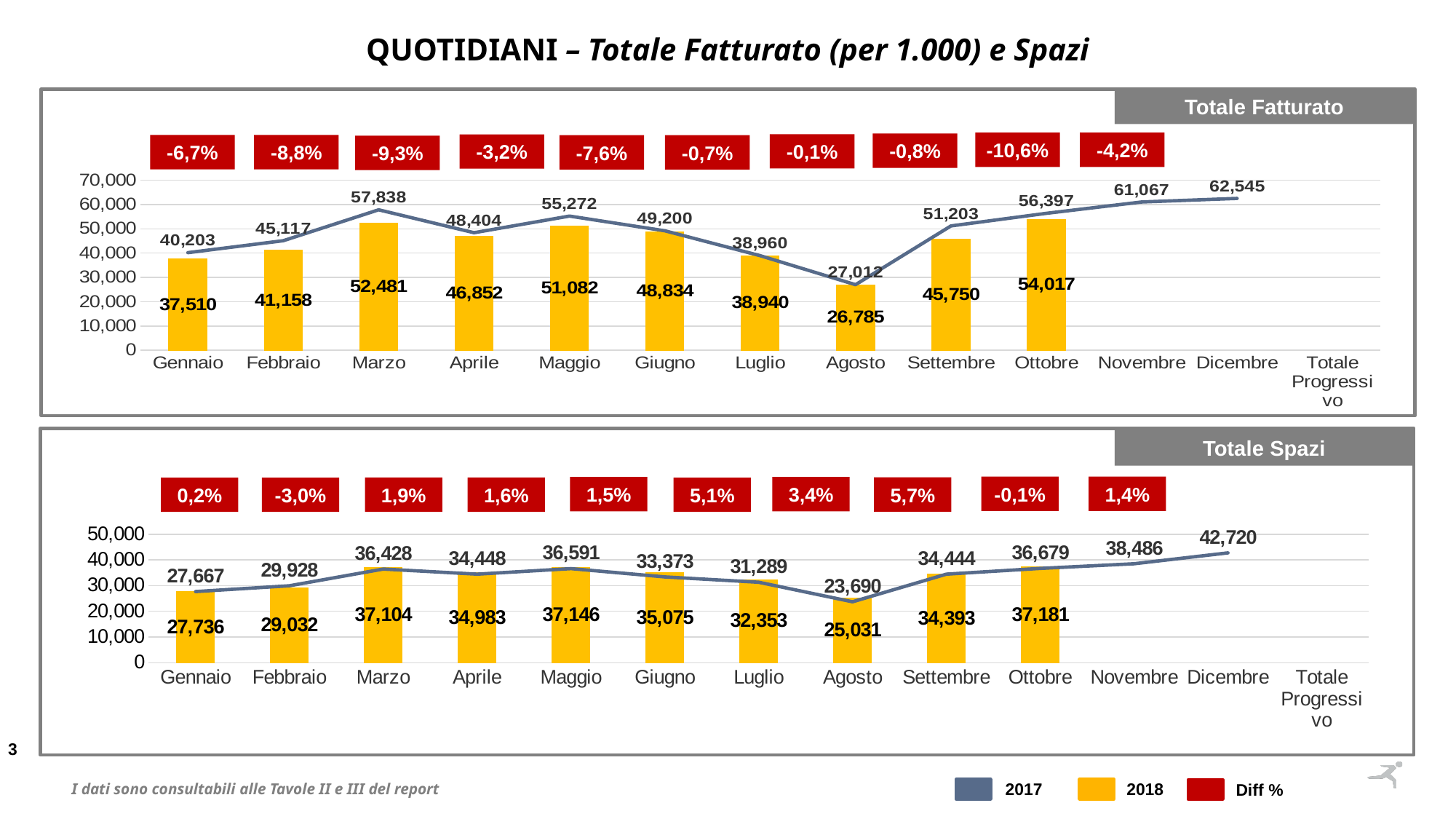
In the Totale Spazi chart, what is the 2018 value for Luglio? 32,353 In the Totale Spazi chart, which month has the highest 2017 value? Dicembre In the Totale Fatturato chart, what is the 2018 value for Marzo? 52,481 In the Totale Spazi chart, which is larger for Giugno: the 2017 value or the 2018 value? 2018 How many series does the legend at the bottom of the slide list? 3 In the Totale Fatturato chart, which month has the highest 2018 bar? Ottobre In the Totale Fatturato chart, what is the Diff % shown for Ottobre? -10,6% In the Totale Spazi chart, what is the difference between the 2018 and 2017 values for Marzo? 676 In the Totale Fatturato chart, which month has the lowest 2018 bar? Agosto In the Totale Fatturato chart, what is the 2017 value for Dicembre? 62,545 In the Totale Spazi chart, how many months have a 2018 bar plotted? 10 In the Totale Fatturato chart, what is the difference between the 2017 and 2018 values for Agosto? 227